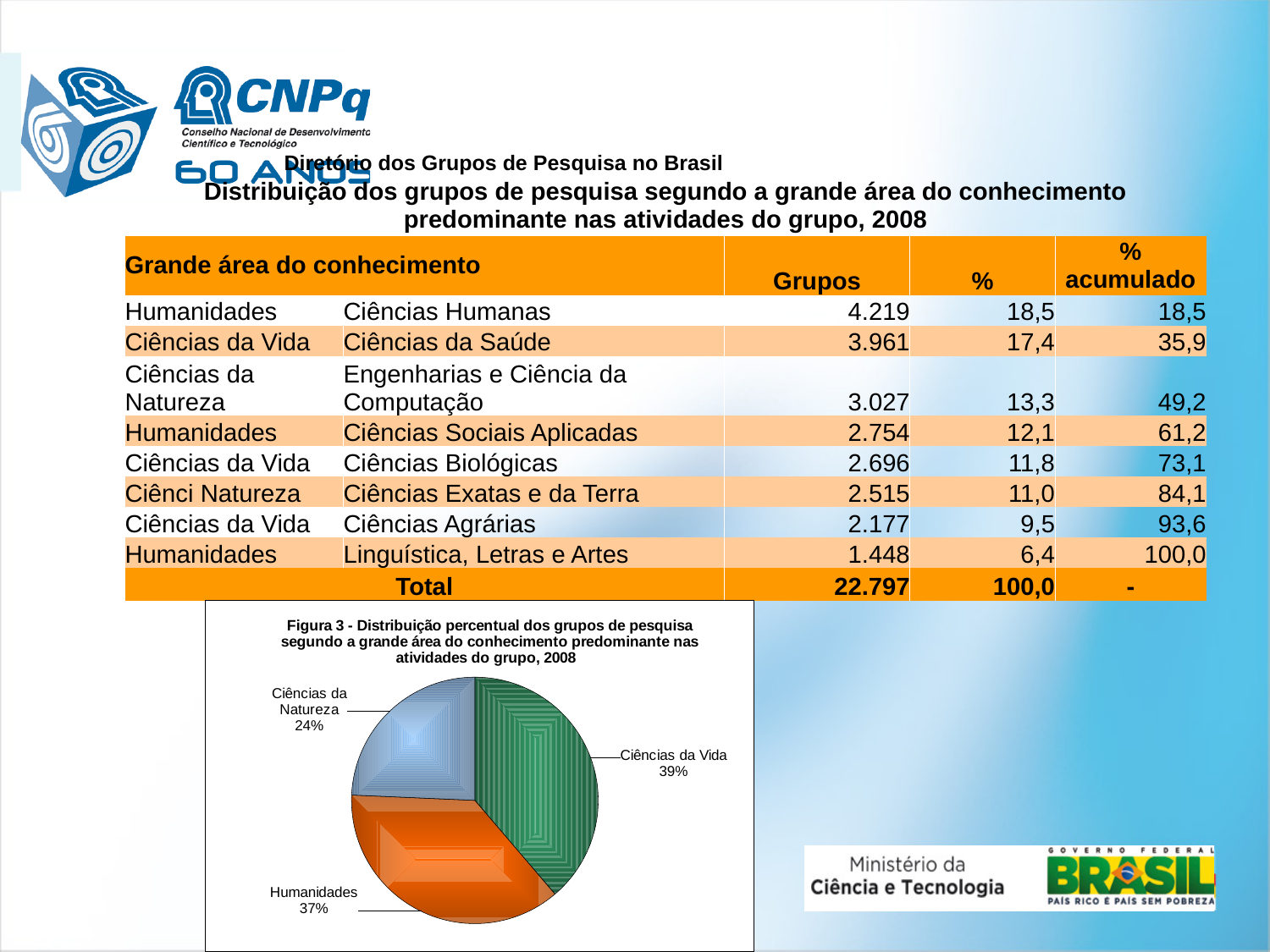
In the pie chart, what is the difference in percentage points between Ciências da Vida and Ciências da Natureza? 15 What colour is the Humanidades slice in the pie chart? orange In the pie chart, what is the difference in percentage points between Humanidades and Ciências da Natureza? 13 In the pie chart, what share of research groups belongs to Ciências da Natureza? 24% Which slice of the pie chart is the smallest? Ciências da Natureza What year is referenced in the title of the pie chart? 2008 In the pie chart, which is larger: the share for Humanidades or the share for Ciências da Natureza? Humanidades How many slices does the pie chart have? 3 Which slice of the pie chart is the largest? Ciências da Vida In the pie chart, what share of research groups belongs to Humanidades? 37% What kind of chart is shown in Figura 3 on the slide? pie chart In the pie chart, what share of research groups belongs to Ciências da Vida? 39%